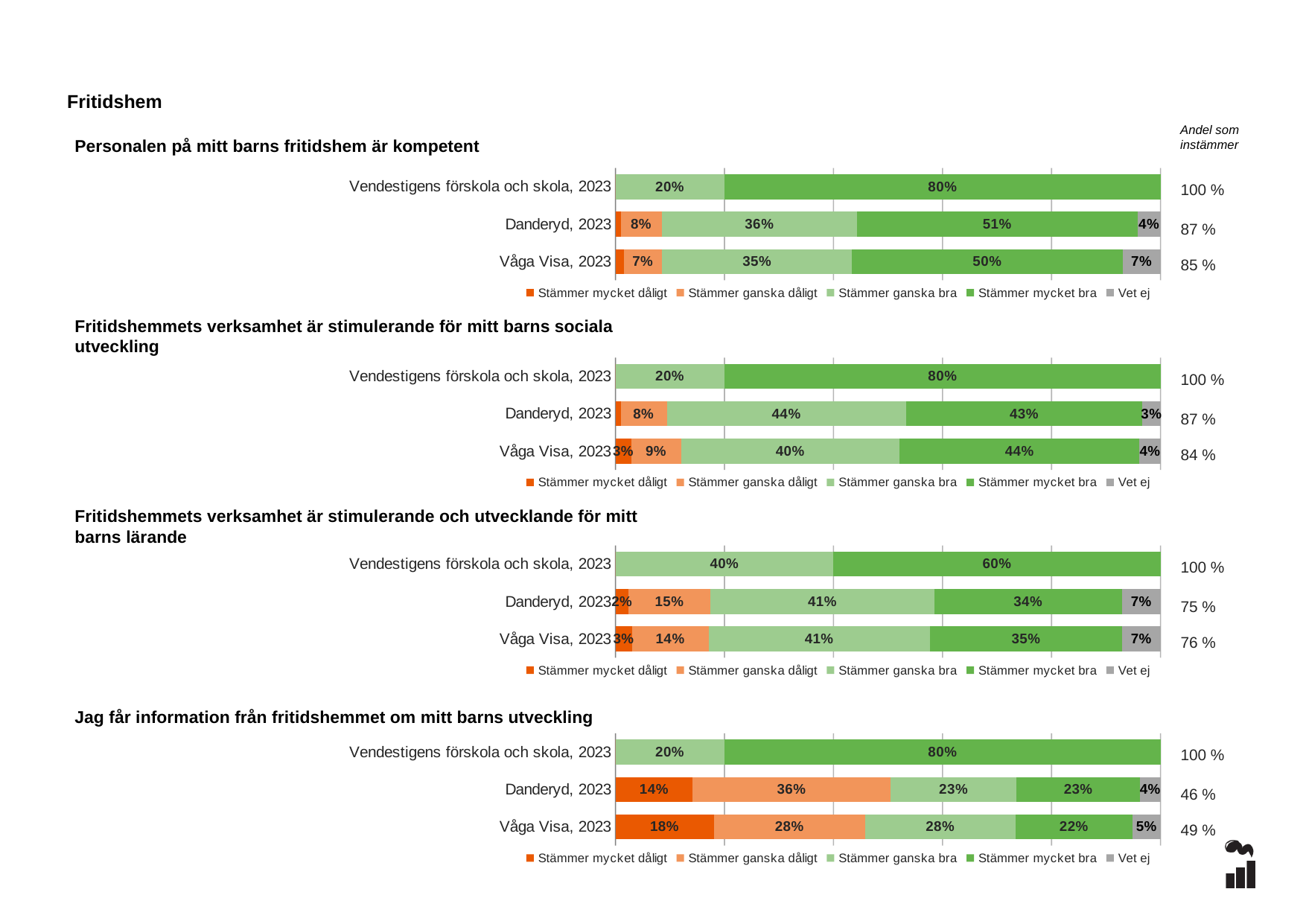
In the chart 'Fritidshemmets verksamhet är stimulerande för mitt barns sociala utveckling', what is the 'Stämmer ganska bra' value for Danderyd, 2023? 44% In the chart 'Personalen på mitt barns fritidshem är kompetent', what is the 'Stämmer mycket bra' value for Danderyd, 2023? 51% In the chart 'Fritidshemmets verksamhet är stimulerande och utvecklande för mitt barns lärande', what is the difference between the 'Stämmer mycket bra' values for Vendestigens förskola och skola, 2023 and Våga Visa, 2023? 25% How many categories are shown in the chart 'Jag får information från fritidshemmet om mitt barns utveckling'? 3 In the chart 'Fritidshemmets verksamhet är stimulerande för mitt barns sociala utveckling', which category has the lowest 'Andel som instämmer'? Våga Visa, 2023 In the chart 'Jag får information från fritidshemmet om mitt barns utveckling', what is the 'Stämmer mycket dåligt' value for Våga Visa, 2023? 18% In the chart 'Jag får information från fritidshemmet om mitt barns utveckling', which is larger: the 'Stämmer ganska dåligt' value for Danderyd, 2023 or for Våga Visa, 2023? Danderyd, 2023 In the chart 'Jag får information från fritidshemmet om mitt barns utveckling', what is the 'Andel som instämmer' value for Danderyd, 2023? 46 % How many series does the legend list for the chart 'Personalen på mitt barns fritidshem är kompetent'? 5 What kind of chart is 'Fritidshemmets verksamhet är stimulerande för mitt barns sociala utveckling'? Stacked bar chart In the chart 'Personalen på mitt barns fritidshem är kompetent', what is the 'Andel som instämmer' value for Våga Visa, 2023? 85 % In the chart 'Fritidshemmets verksamhet är stimulerande och utvecklande för mitt barns lärande', what is the 'Stämmer ganska dåligt' value for Danderyd, 2023? 15%